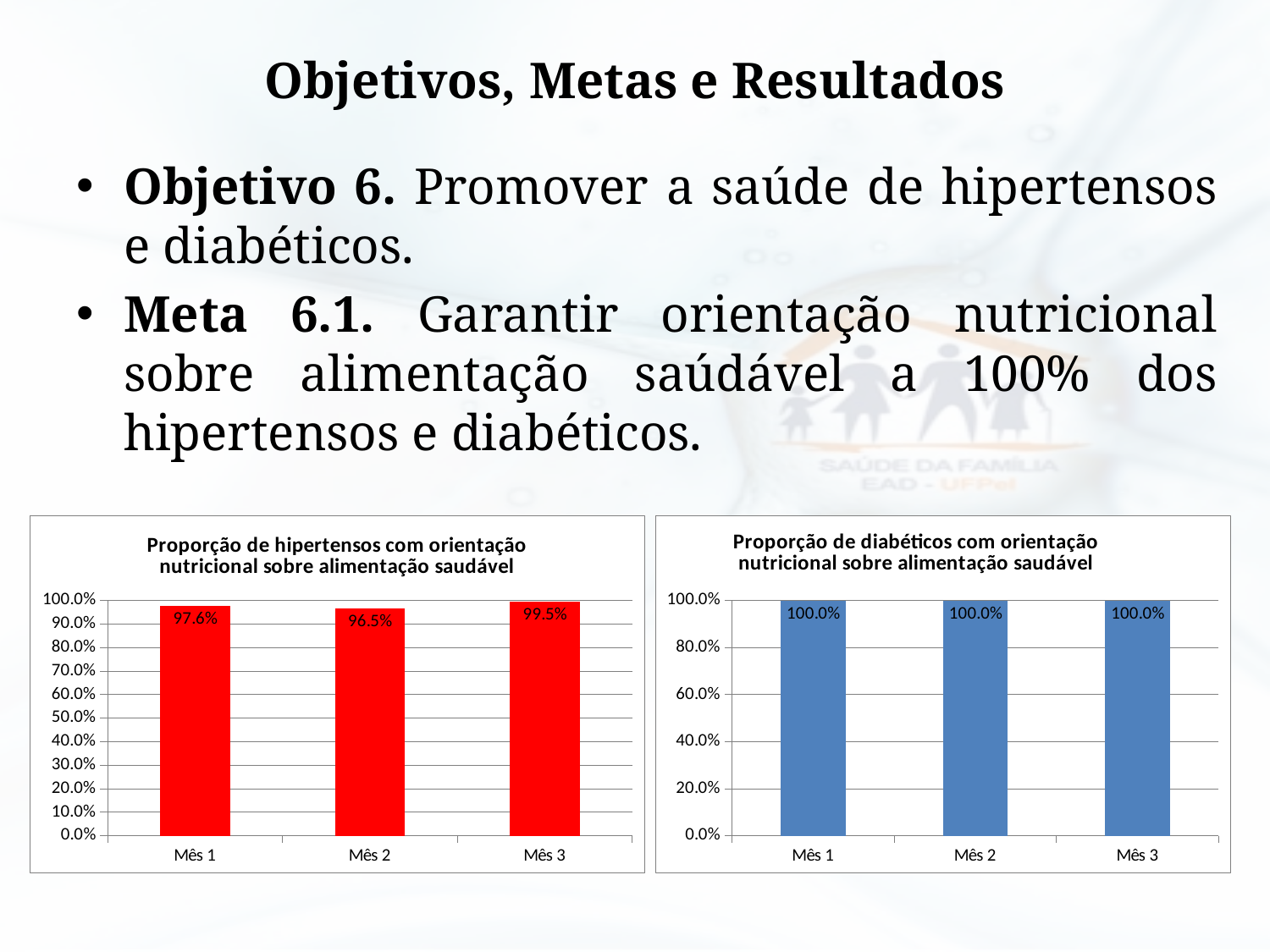
In the right chart (Proporção de diabéticos com orientação nutricional sobre alimentação saudável), how many months are plotted? 3 In the left chart (Proporção de hipertensos com orientação nutricional sobre alimentação saudável), what is the value for Mês 3? 99.5% What kind of chart is the right chart (Proporção de diabéticos com orientação nutricional sobre alimentação saudável)? Bar chart In the left chart (Proporção de hipertensos com orientação nutricional sobre alimentação saudável), which month has the highest value? Mês 3 What colour are the bars in the left chart (Proporção de hipertensos com orientação nutricional sobre alimentação saudável)? Red In the left chart (Proporção de hipertensos com orientação nutricional sobre alimentação saudável), which month has the lowest value? Mês 2 In the right chart (Proporção de diabéticos com orientação nutricional sobre alimentação saudável), what is the value for Mês 2? 100.0% In the left chart (Proporção de hipertensos com orientação nutricional sobre alimentação saudável), what is the difference between the values for Mês 3 and Mês 2? 3.0% In the left chart (Proporção de hipertensos com orientação nutricional sobre alimentação saudável), is the value for Mês 2 greater or less than 90.0%? greater In the left chart (Proporção de hipertensos com orientação nutricional sobre alimentação saudável), what is the value for Mês 1? 97.6% In the left chart (Proporção de hipertensos com orientação nutricional sobre alimentação saudável), which is larger, the value for Mês 1 or Mês 2? Mês 1 In the left chart (Proporção de hipertensos com orientação nutricional sobre alimentação saudável), what is the value for Mês 2? 96.5%